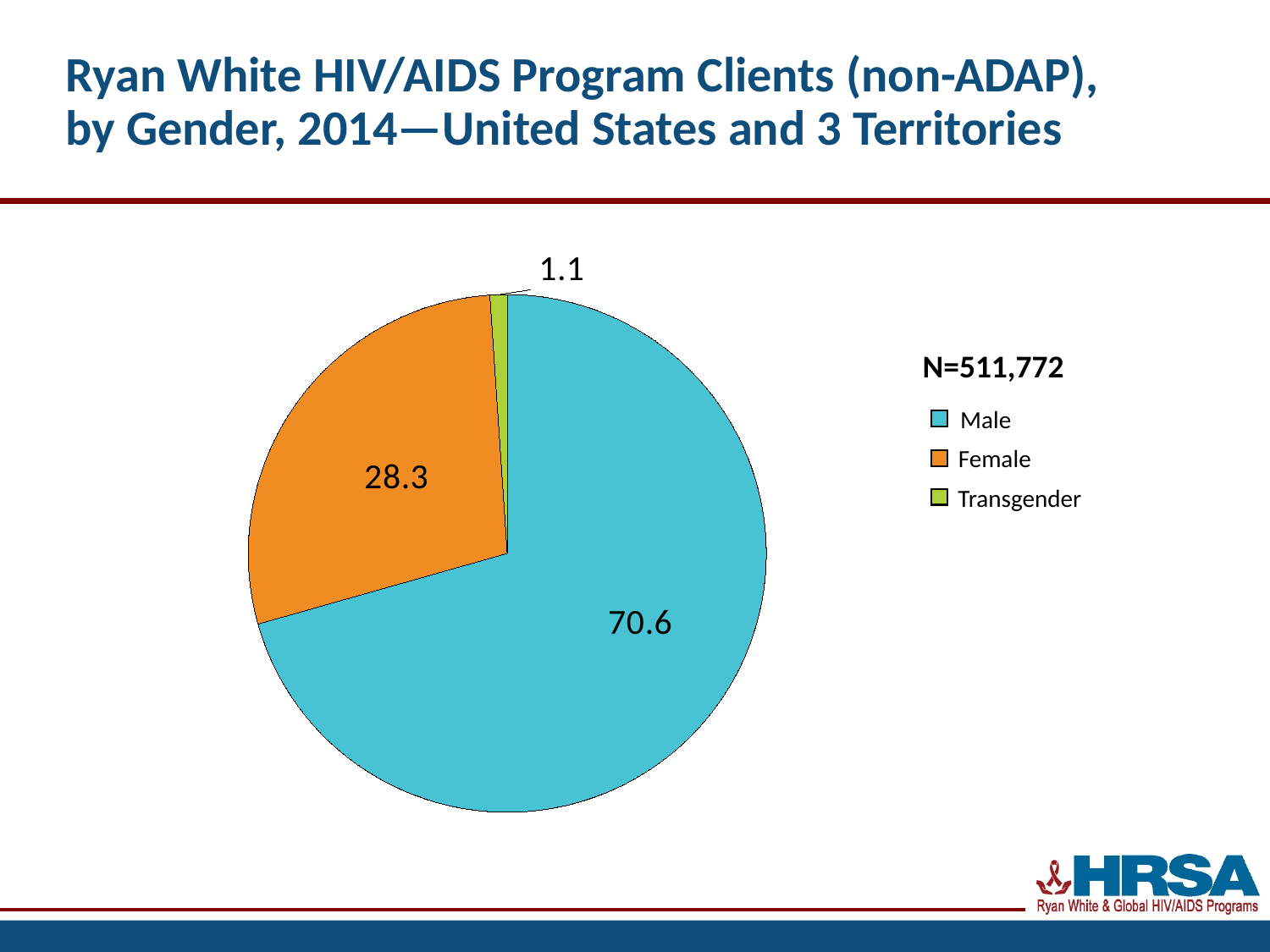
What is the N value shown next to the legend? N=511,772 What kind of chart is shown on the slide? pie chart What is the value shown for Male? 70.6 What is the value shown for Female? 28.3 Which category has the smallest slice of the pie? Transgender Which category has the largest slice of the pie? Male How many categories does the pie chart show? 3 What colour is the Female slice of the pie? orange How many entries does the legend list? 3 Which is larger, the value for Female or the value for Transgender? Female What is the difference between the values for Male and Female? 42.3 What is the value shown for Transgender? 1.1